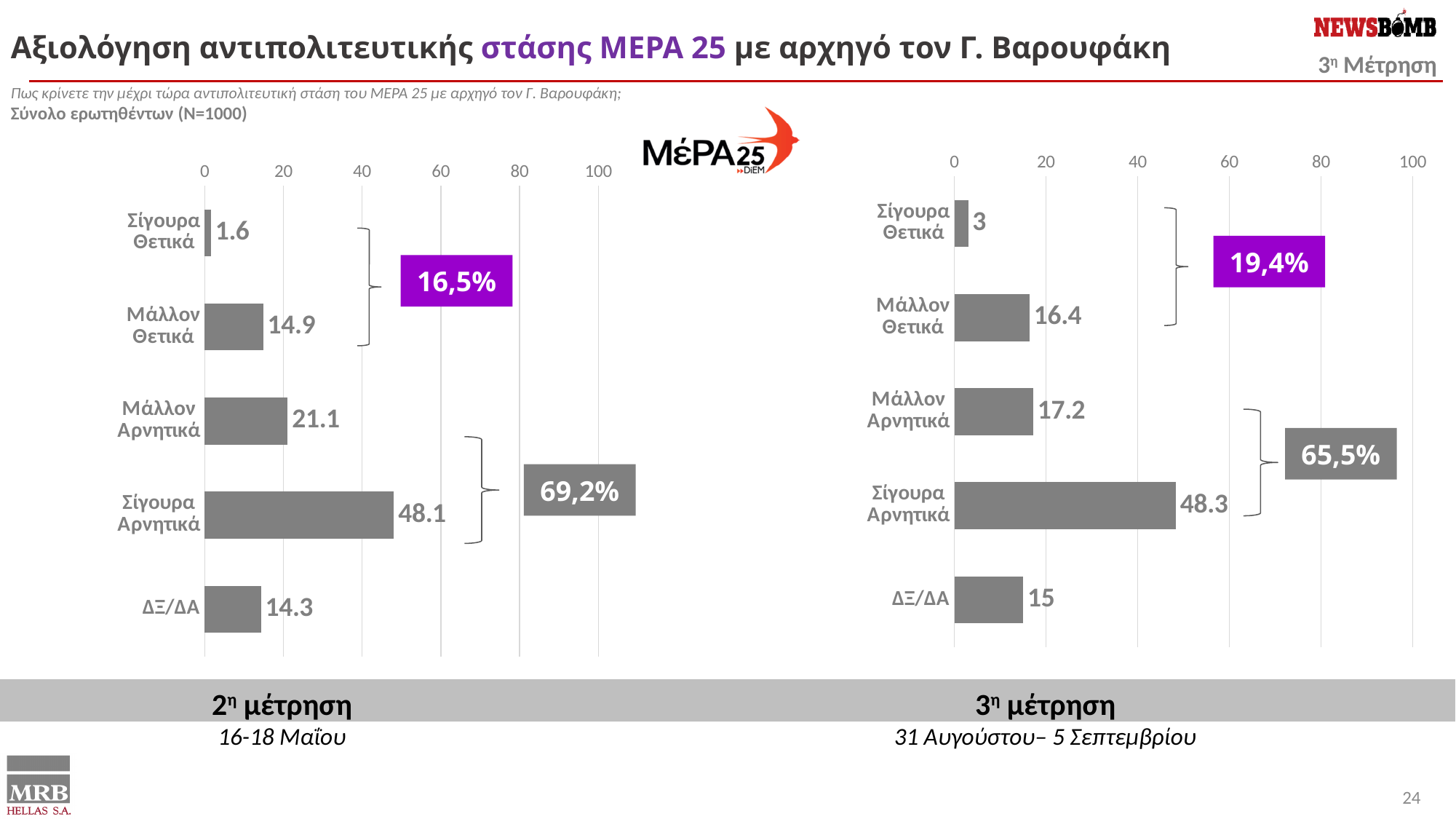
In the right chart (3η μέτρηση), which category has the lowest value? Σίγουρα Θετικά In the left chart (2η μέτρηση), what is the value for Σίγουρα Αρνητικά? 48.1 In the right chart (3η μέτρηση), is the value for Σίγουρα Αρνητικά greater or less than 40? greater How many categories does the left chart (2η μέτρηση) show? 5 What kind of chart is the right chart (3η μέτρηση)? bar chart In the left chart (2η μέτρηση), what combined percentage is shown in the grey box for the negative responses? 69,2% In the right chart (3η μέτρηση), what is the difference between Σίγουρα Αρνητικά and Μάλλον Αρνητικά? 31.1 In the right chart (3η μέτρηση), what combined percentage is shown in the purple box for the positive responses? 19,4% In the left chart (2η μέτρηση), which is larger: Μάλλον Αρνητικά or Μάλλον Θετικά? Μάλλον Αρνητικά In the left chart (2η μέτρηση), what is the value for ΔΞ/ΔΑ? 14.3 In the right chart (3η μέτρηση), what is the value for Μάλλον Θετικά? 16.4 In the left chart (2η μέτρηση), which category has the highest value? Σίγουρα Αρνητικά